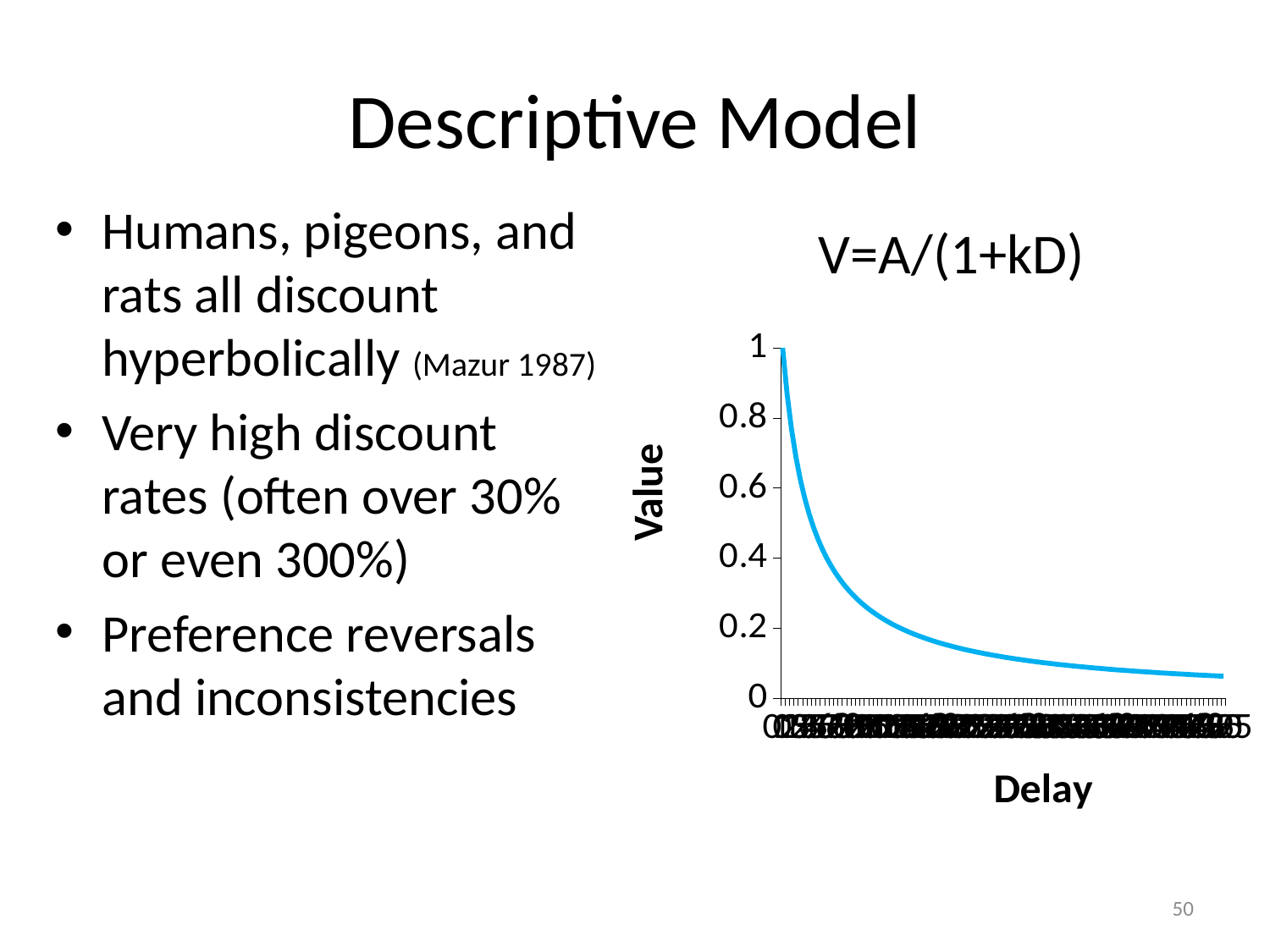
What is the highest value the curve reaches on the chart? 1 Is the value at the far right end of the curve greater or less than 0.2? less What is the title of the chart? V=A/(1+kD) What is the label of the chart's vertical axis? Value Is the value at the far right end of the curve greater or less than 0? greater Do the values on the chart rise or fall as Delay increases along the x axis? fall What kind of chart is shown on the slide? line chart